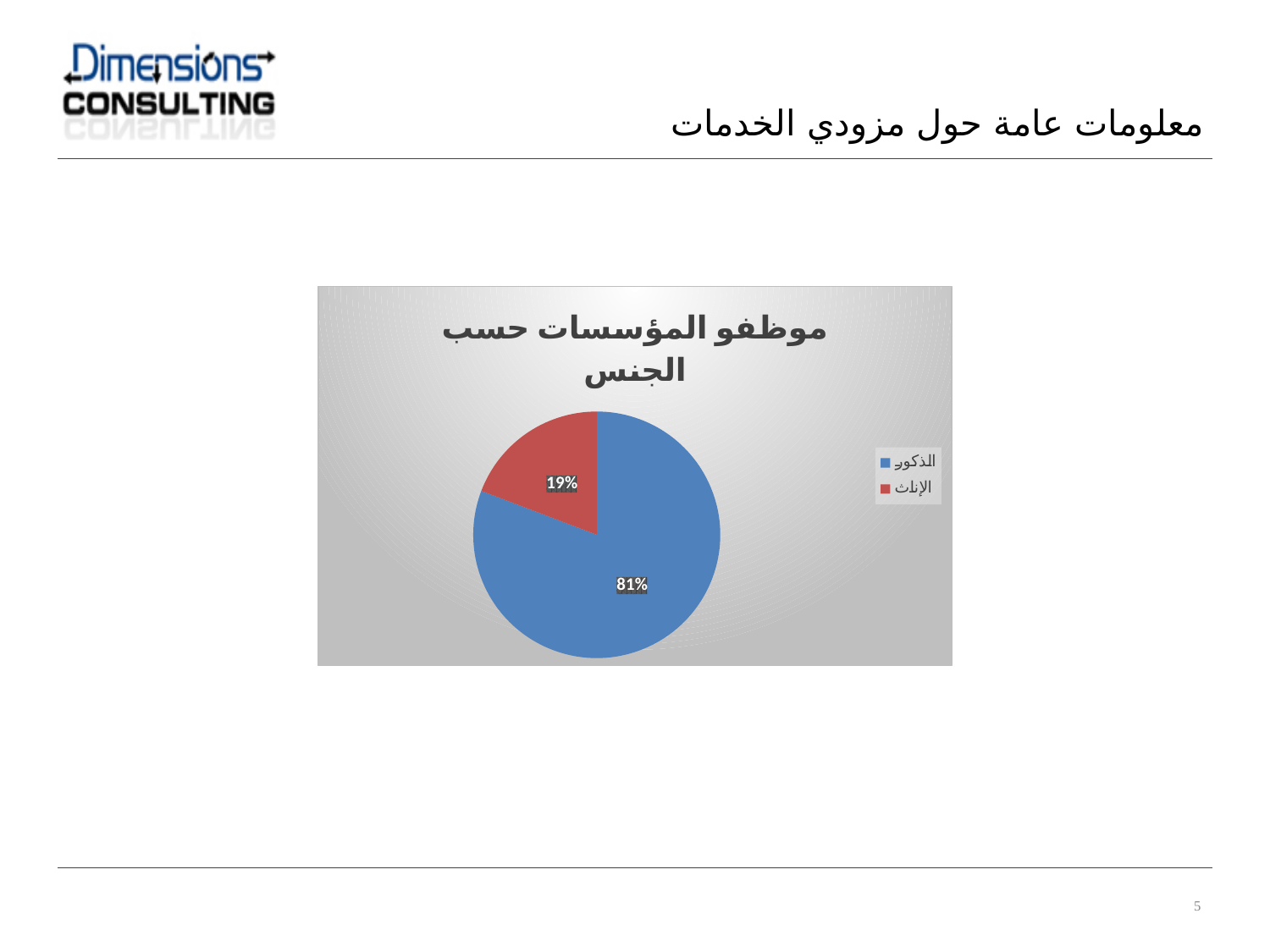
What is the title of the chart? موظفو المؤسسات حسب الجنس Which category has the largest slice of the pie? الذكور Which slice is larger, الذكور or الإناث? الذكور Which category has the smallest slice of the pie? الإناث How many slices does the pie chart have? 2 What share of the pie is labelled for الذكور? 81% What is the difference in percentage points between the الذكور slice and the الإناث slice? 62 What share of the pie is labelled for الإناث? 19% What colour is the slice for الإناث? Red What kind of chart is shown on the slide? Pie chart How many entries does the legend list? 2